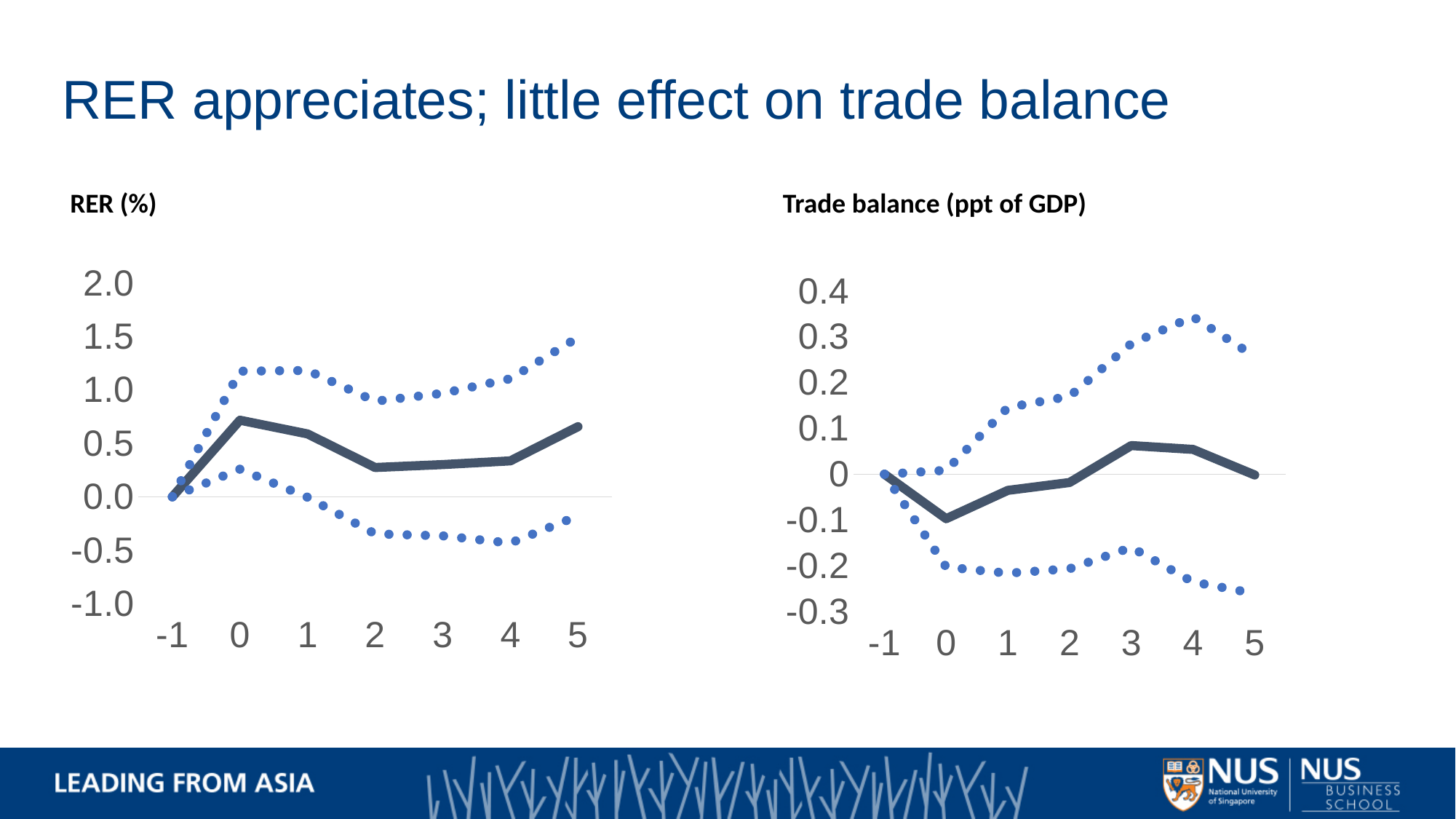
In the RER (%) chart, is the upper dotted line at x = 5 greater or less than 1.0? greater In the RER (%) chart, which is larger: the solid line value at x = 0 or at x = 2? x = 0 In the Trade balance (ppt of GDP) chart, at which x-axis value does the solid line reach its lowest point? 0 In the RER (%) chart, what is the value of the solid line at x = -1? 0.0 In the Trade balance (ppt of GDP) chart, is the solid line at x = 3 greater or less than 0? greater What kind of chart is the RER (%) chart? line chart In the Trade balance (ppt of GDP) chart, does the solid line rise or fall from x = -1 to x = 0? fall In the RER (%) chart, is the value of the solid line at x = 0 greater or less than 0.5? greater In the RER (%) chart, at which x-axis value does the solid line reach its highest point? 0 How many points are on the x axis of the Trade balance (ppt of GDP) chart? 7